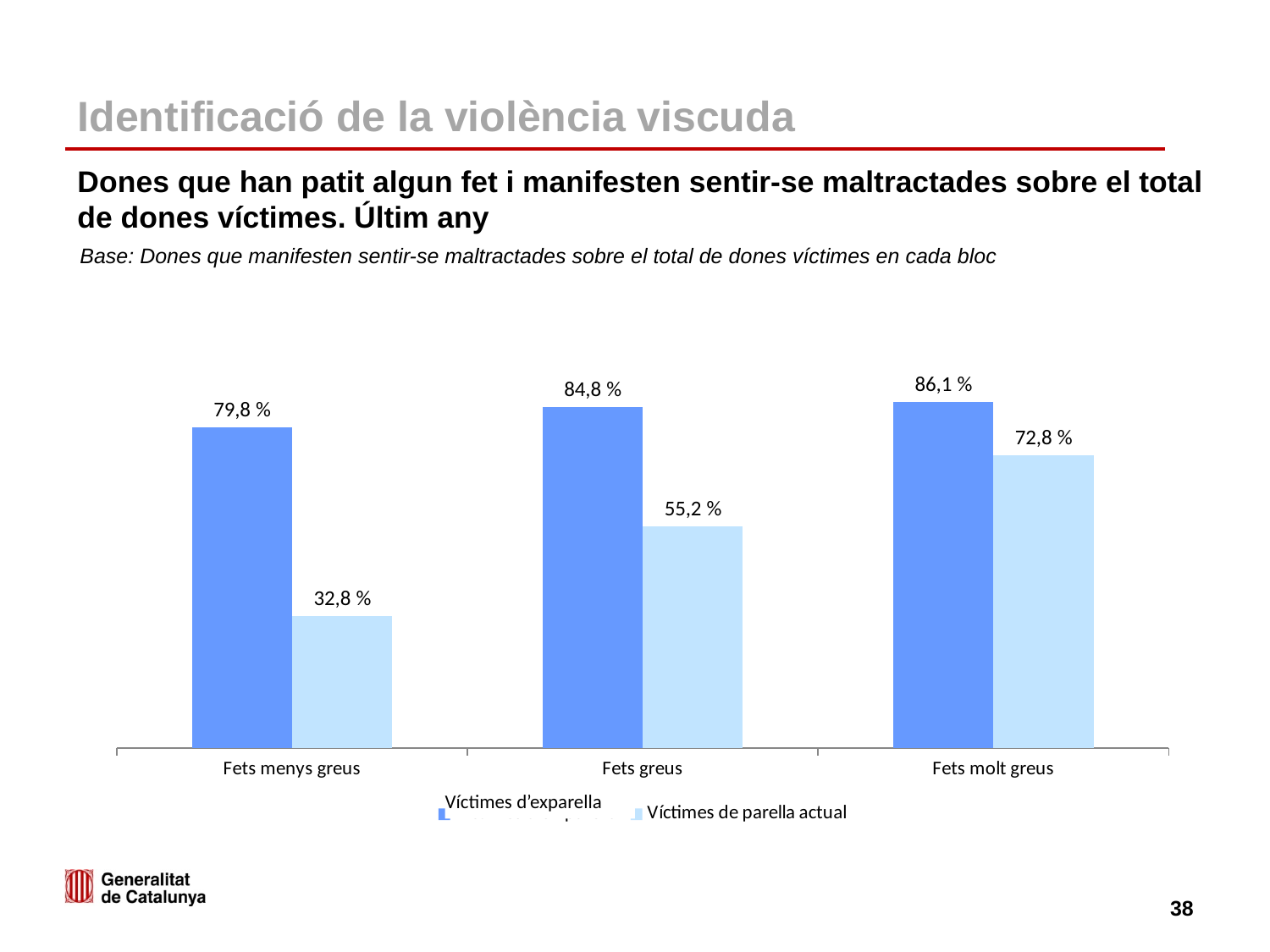
What is the difference between Víctimes d'exparella and Víctimes de parella actual in the Fets menys greus category? 47,0 % What is the value for Víctimes d'exparella in the Fets menys greus category? 79,8 % What kind of chart is shown on the slide? Bar chart What is the value for Víctimes de parella actual in the Fets molt greus category? 72,8 % Which is larger in the Fets greus category: Víctimes d'exparella or Víctimes de parella actual? Víctimes d'exparella Which category has the highest value for Víctimes d'exparella? Fets molt greus How many categories are shown on the x axis? 3 Which category has the lowest value for Víctimes de parella actual? Fets menys greus What is the difference between Víctimes d'exparella and Víctimes de parella actual in the Fets molt greus category? 13,3 % What is the value for Víctimes de parella actual in the Fets greus category? 55,2 % Do the values for Víctimes de parella actual rise or fall from Fets menys greus to Fets molt greus? Rise How many series does the legend list? 2